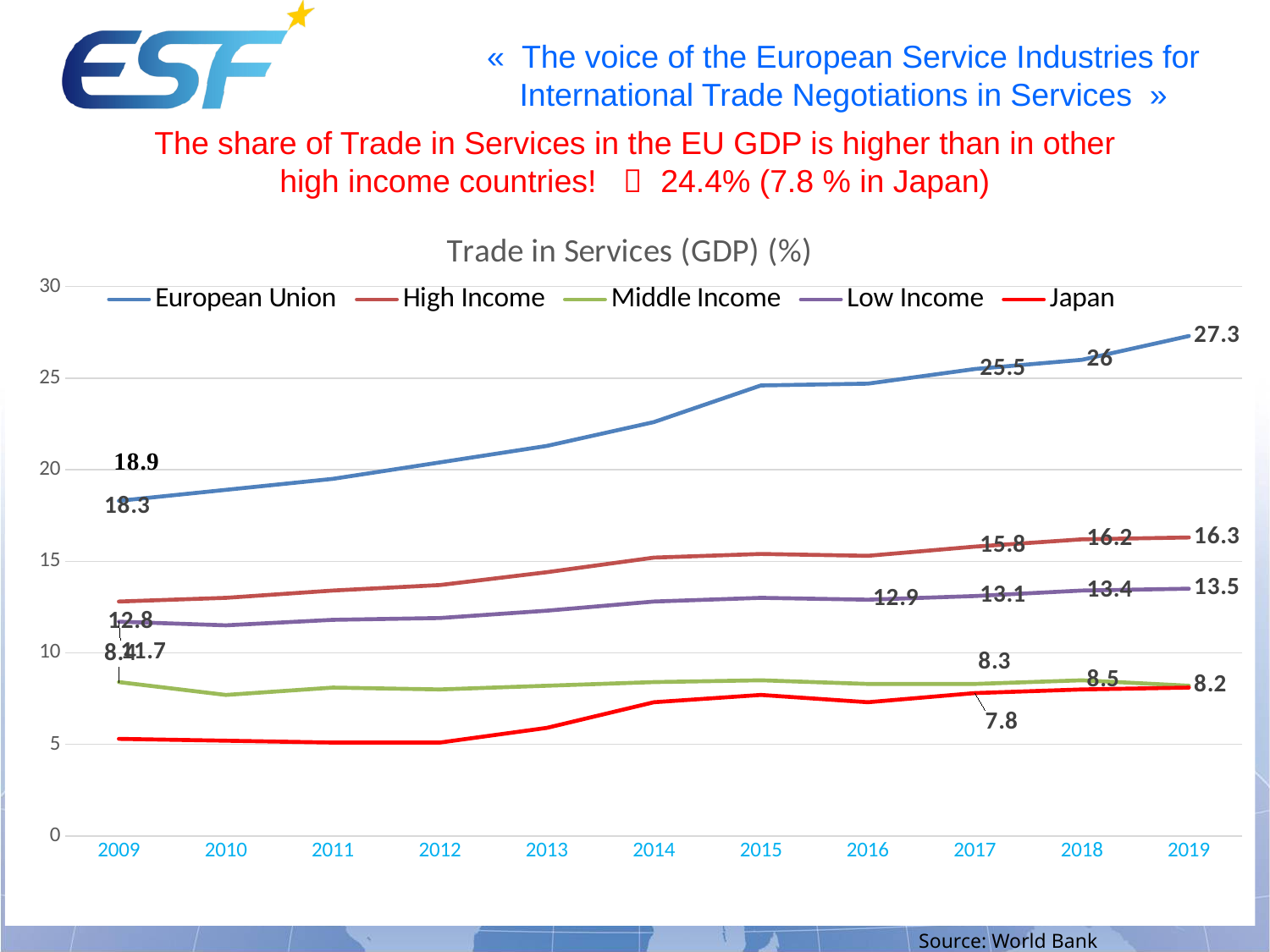
Which series has the highest value in 2019? European Union What is the value for the European Union in 2018? 26 What is the value for High Income in 2019? 16.3 Does the European Union line rise or fall from 2009 to 2019? rise How many series does the legend list? 5 What is the value for Japan in 2017? 7.8 Is the value for Japan in 2012 greater or less than 10? less What is the difference between the European Union and High Income values in 2019? 11 What is the value for Low Income in 2017? 13.1 How many years are shown on the x axis? 11 Which series has the lowest value in 2009? Japan What is the value for the European Union in 2019? 27.3